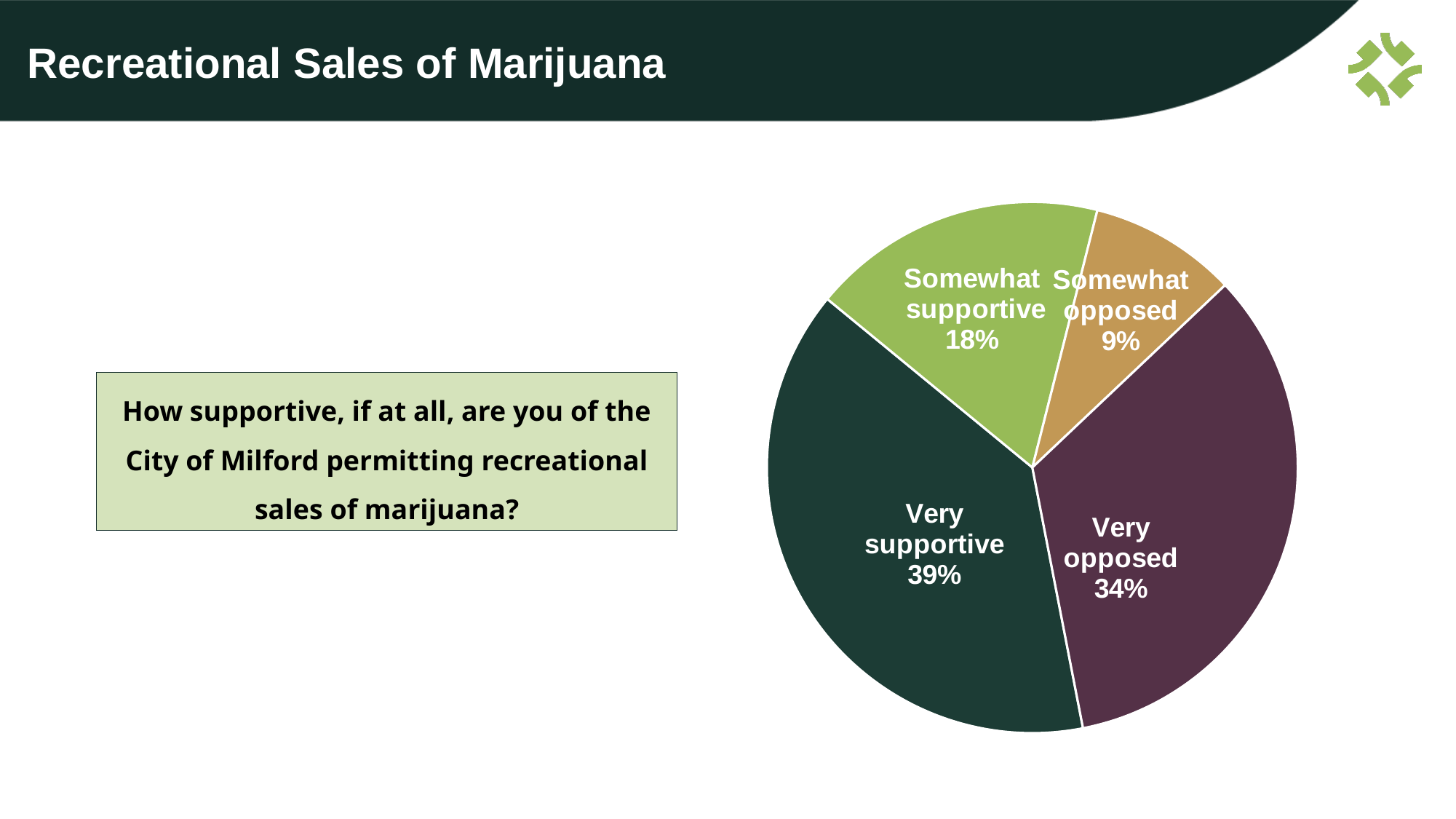
How many response categories are shown in the pie chart? 4 Which is larger, the somewhat supportive slice or the somewhat opposed slice? Somewhat supportive What percentage of respondents are very supportive of the City of Milford permitting recreational sales of marijuana? 39% What is the difference in percentage points between the very supportive and very opposed slices? 5 What colour is the very opposed slice of the pie chart? Dark purple What percentage of respondents are somewhat supportive? 18% Which response category has the smallest share of the pie? Somewhat opposed Which response category has the largest share of the pie? Very supportive What is the difference in percentage points between the somewhat supportive and somewhat opposed slices? 9 What percentage of respondents are somewhat opposed? 9% What percentage of respondents are very opposed? 34% What kind of chart is shown on the slide? Pie chart